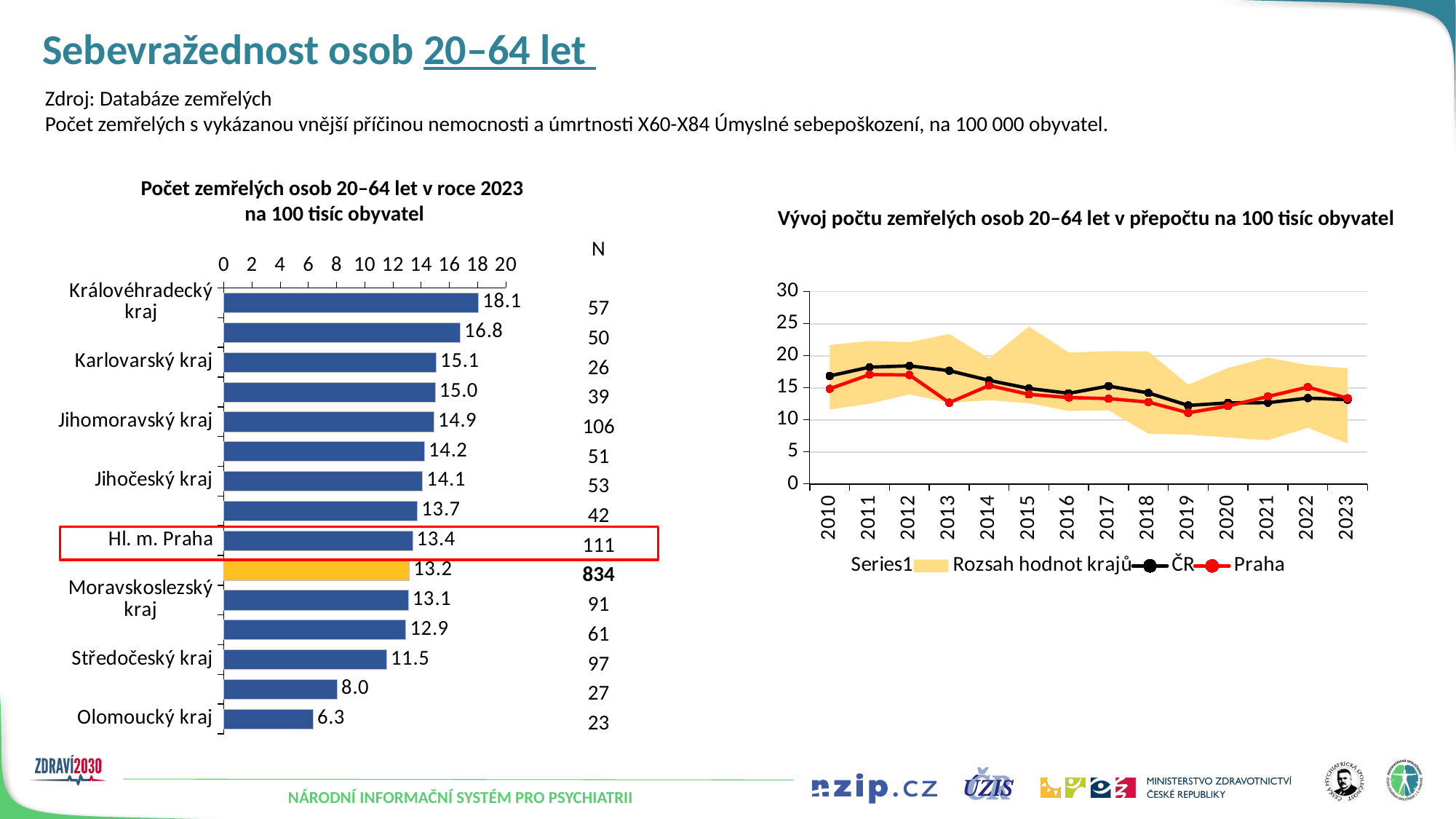
What kind of chart is the chart on the left of the slide? Bar chart In the bar chart on the left, which region has the lowest value? Olomoucký kraj In the line chart on the right, is the value for Praha in 2019 greater or less than 15? less In the line chart on the right, does the ČR line overall rise or fall from 2010 to 2023? fall In the bar chart on the left, which has the larger value, Karlovarský kraj or Jihomoravský kraj? Karlovarský kraj In the bar chart on the left, what is the value for Hl. m. Praha? 13.4 In the line chart on the right, is the value for ČR in 2012 greater or less than 15? greater How many bars are plotted in the bar chart on the left? 15 In the bar chart on the left, what is the difference between the values for Královéhradecký kraj and Olomoucký kraj? 11.8 In the bar chart 'Počet zemřelých osob 20–64 let v roce 2023 na 100 tisíc obyvatel', what is the value for Královéhradecký kraj? 18.1 In the bar chart on the left, which region has the highest value? Královéhradecký kraj How many entries does the legend of the chart 'Vývoj počtu zemřelých osob 20–64 let v přepočtu na 100 tisíc obyvatel' list? 4